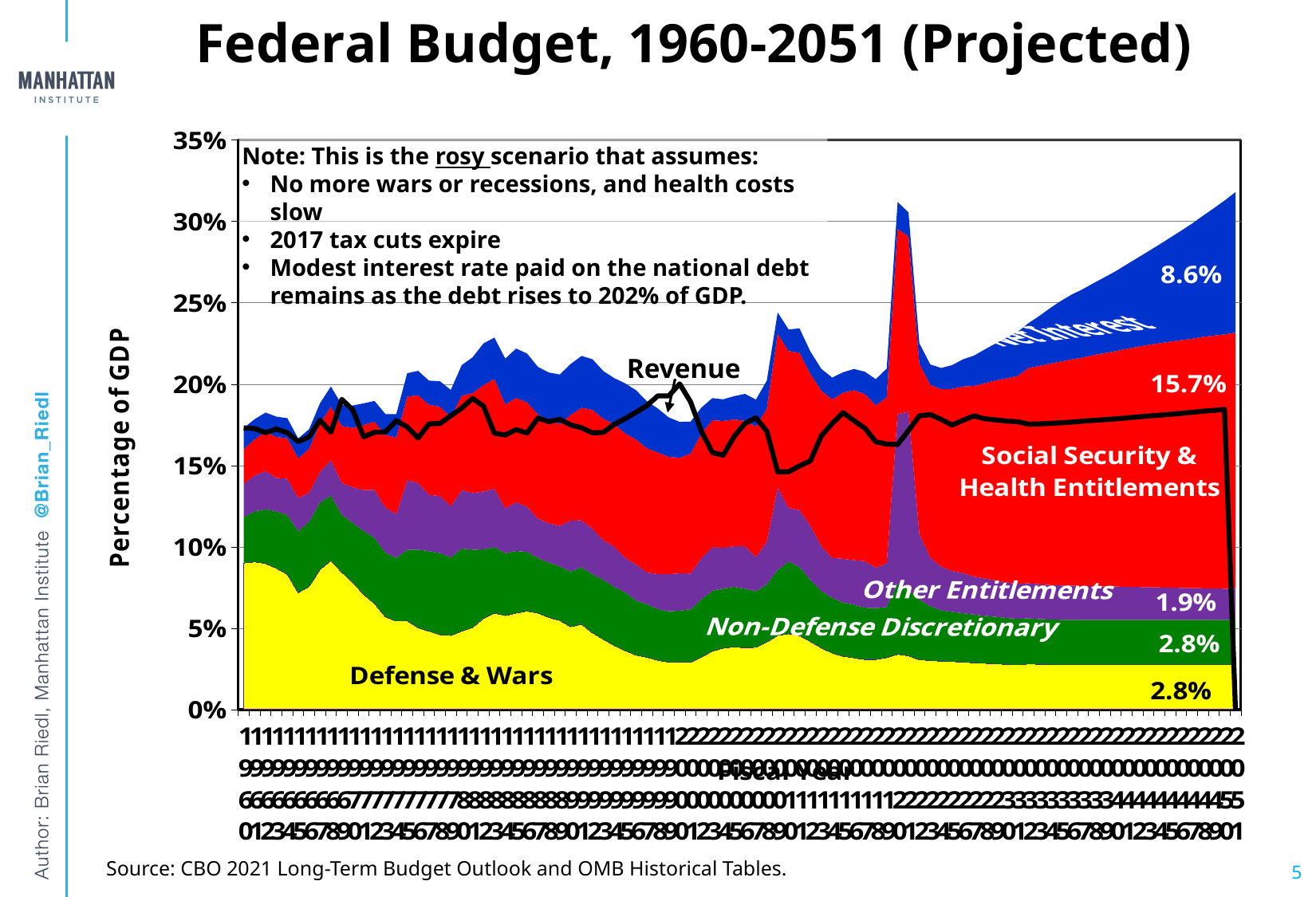
Is the Revenue line at the end of the chart (2051) greater or less than 20%? less What is the projected value for Defense & Wars at the end of the chart (2051)? 2.8% What is the projected value for Social Security & Health Entitlements at the end of the chart (2051)? 15.7% What is the difference between the 2051 values for Social Security & Health Entitlements and Net Interest? 7.1% What kind of chart is shown on the slide? Stacked area chart with a line (Revenue) overlaid What is the projected value for Net Interest at the end of the chart (2051)? 8.6% Does the Net Interest area rise or fall as the chart approaches 2051? rise Which spending category has the smallest labeled value at the end of the chart (2051)? Other Entitlements What is the projected value for Other Entitlements at the end of the chart (2051)? 1.9% How many spending categories are stacked in the chart? 5 Which spending category has the largest labeled value at the end of the chart (2051)? Social Security & Health Entitlements What is the total of the five labeled spending values at the end of the chart (2051)? 31.8%